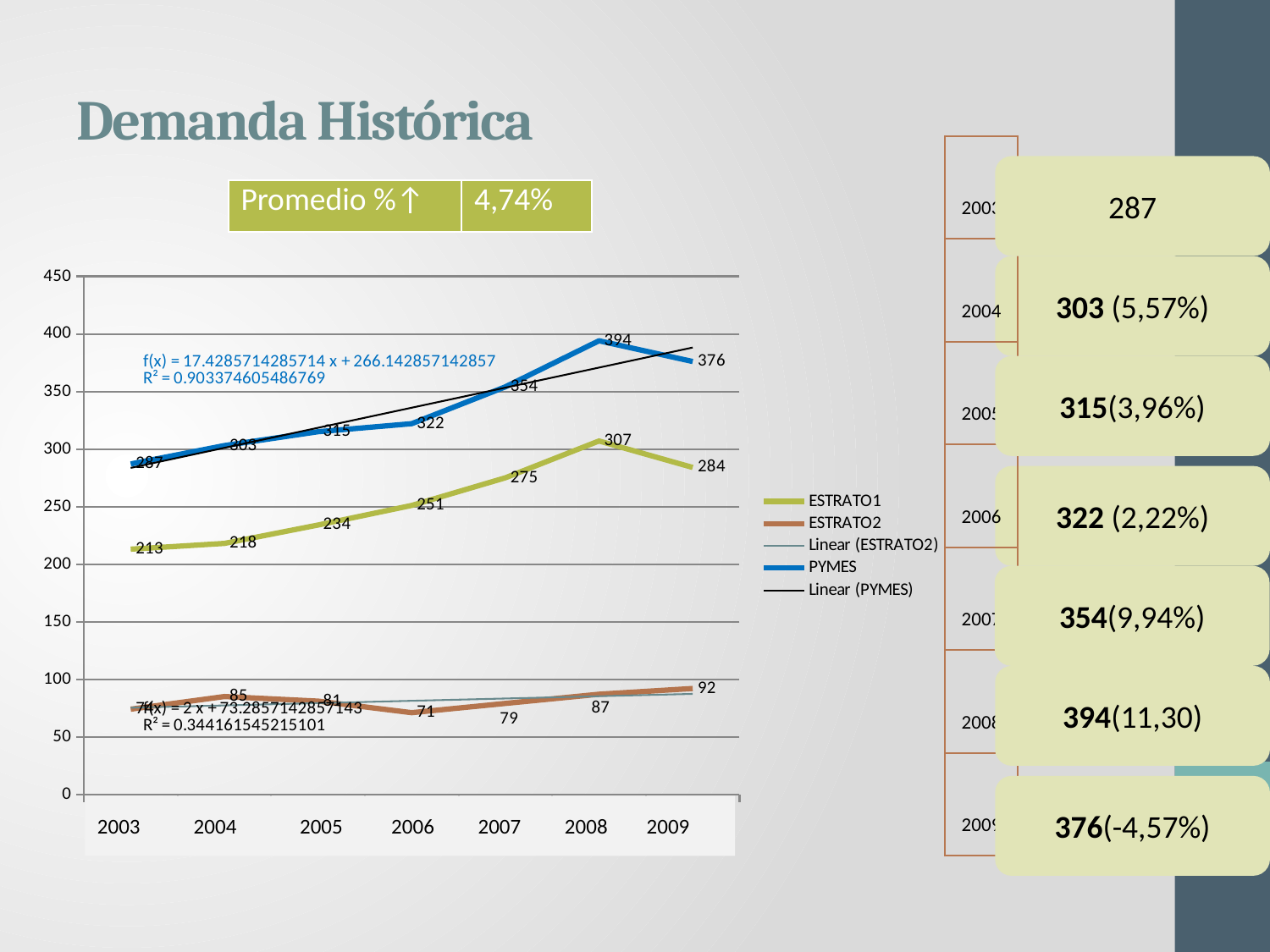
Which is larger in 2007: the ESTRATO1 value or the ESTRATO2 value? ESTRATO1 What is the difference between the PYMES values in 2008 and 2009? 18 How many entries does the legend list? 5 What is the value of PYMES in 2008? 394 How many years are shown on the x axis? 7 Is the value of ESTRATO1 in 2008 greater or less than 300? greater What type of chart is shown on the slide? line chart In which year is ESTRATO1 at its lowest value? 2003 In which year does PYMES reach its highest value? 2008 What is the value of ESTRATO2 in 2009? 92 What is the value of ESTRATO1 in 2006? 251 Does the PYMES series rise or fall from 2003 to 2008? rise